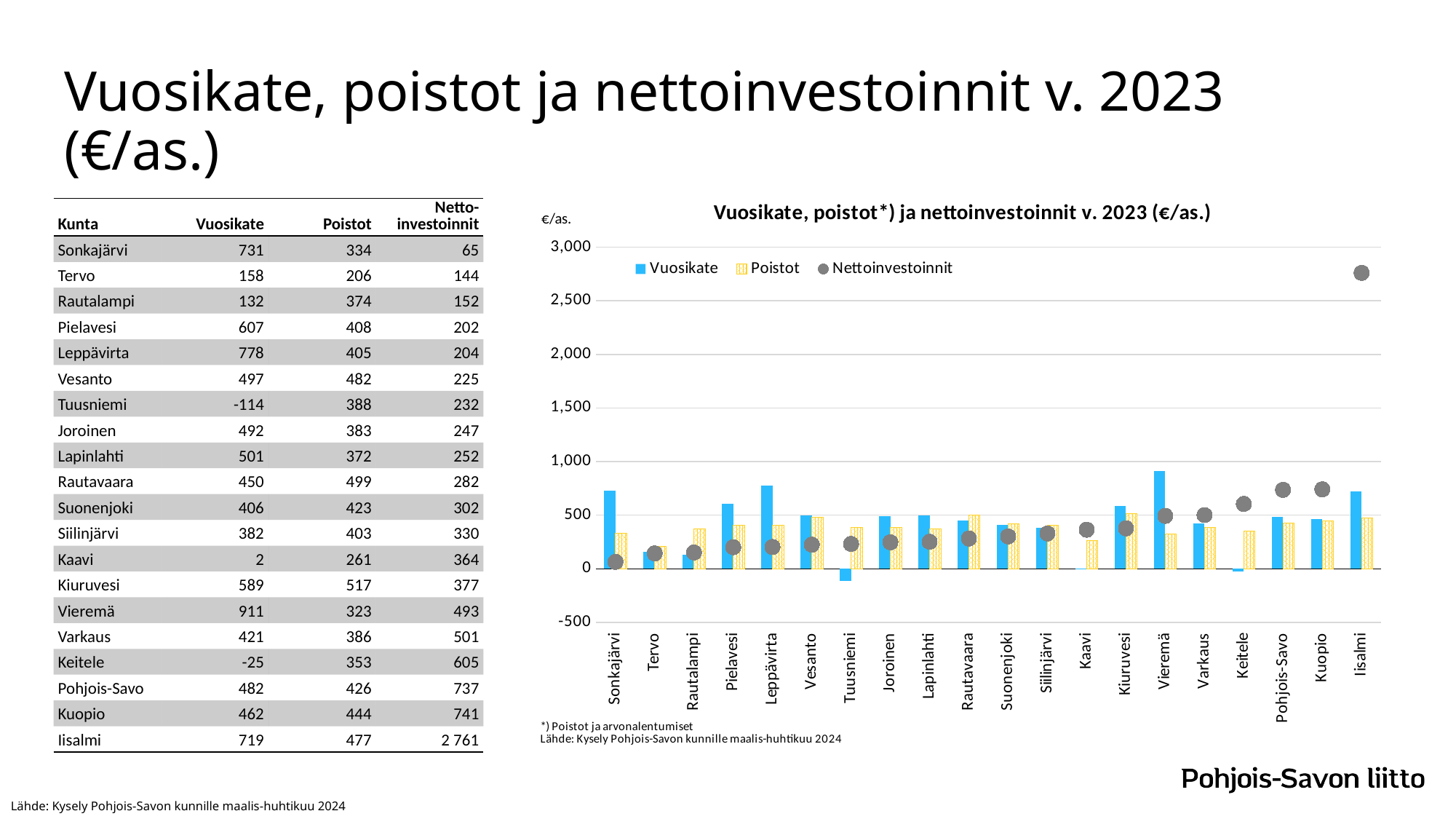
Which is larger, the Nettoinvestoinnit value for Keitele or for Varkaus? Keitele Which municipality has the lowest Vuosikate in the chart? Tuusniemi Is the Nettoinvestoinnit value for Iisalmi greater or less than 2,500? greater What is the Vuosikate value for Sonkajärvi? 731 Which municipality has the highest Nettoinvestoinnit in the chart? Iisalmi Which municipality has the highest Vuosikate in the chart? Vieremä Do the Nettoinvestoinnit values generally rise or fall from left to right along the x axis? rise What is the Nettoinvestoinnit value for Iisalmi? 2 761 How many municipalities (categories) are plotted along the x axis of the chart? 20 What kind of chart is shown on the slide? Bar chart (with dot markers for Nettoinvestoinnit) What is the difference between Vuosikate and Poistot for Sonkajärvi? 397 How many series does the chart legend list? 3